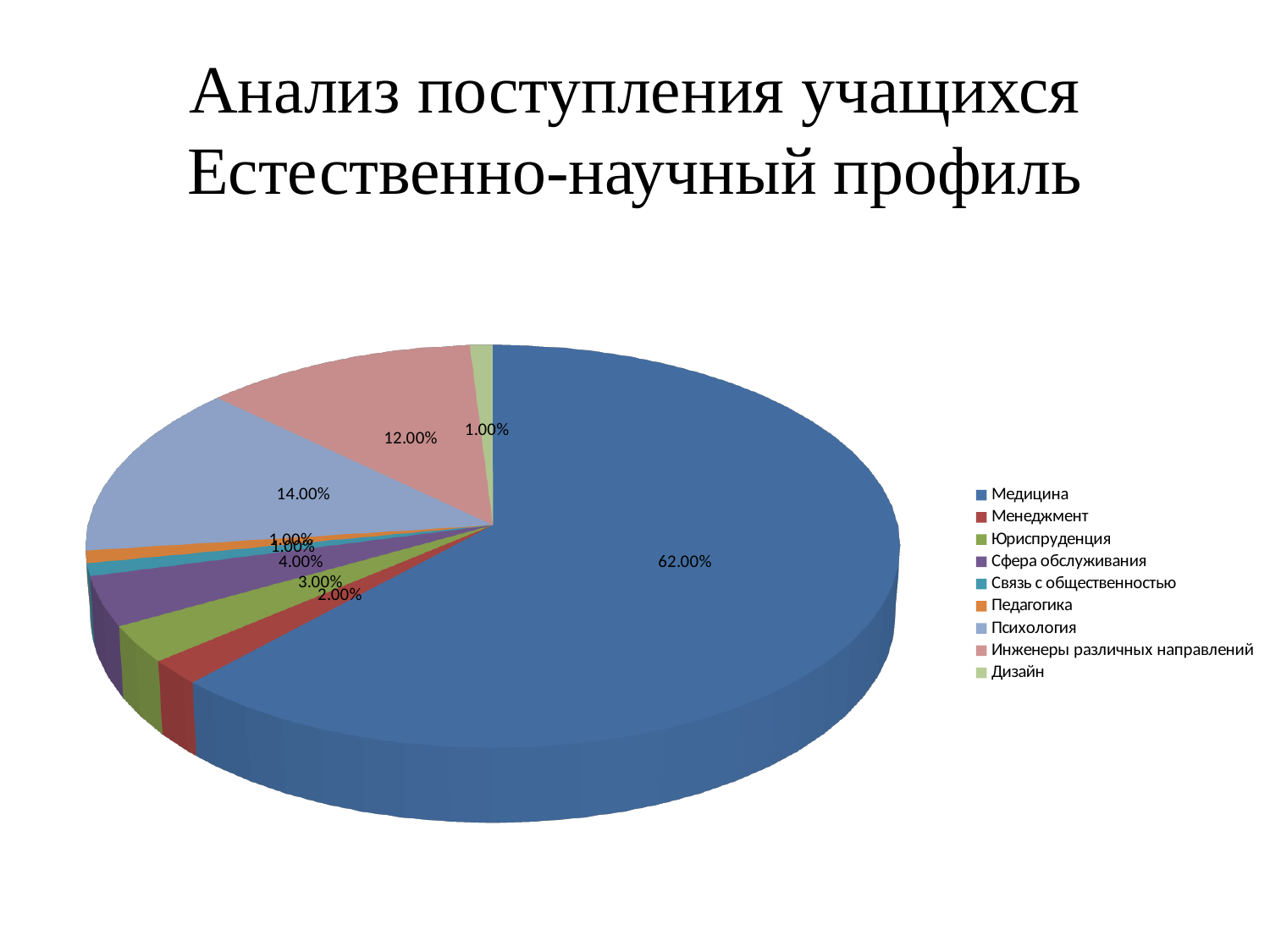
What is the difference between the shares of Психология and Инженеры различных направлений? 2.00% Which category is shown in the last entry of the legend? Дизайн What kind of chart is shown on the slide? Pie chart What share of the pie does Инженеры различных направлений have? 12.00% Which is larger, the share of Сфера обслуживания or the share of Менеджмент? Сфера обслуживания How many categories does the legend list? 9 What share of the pie does Медицина have? 62.00% What is the difference between the shares of Медицина and Психология? 48.00% Which category has the largest slice of the pie? Медицина What share of the pie does Юриспруденция have? 3.00% What share of the pie does Сфера обслуживания have? 4.00% What share of the pie does Психология have? 14.00%